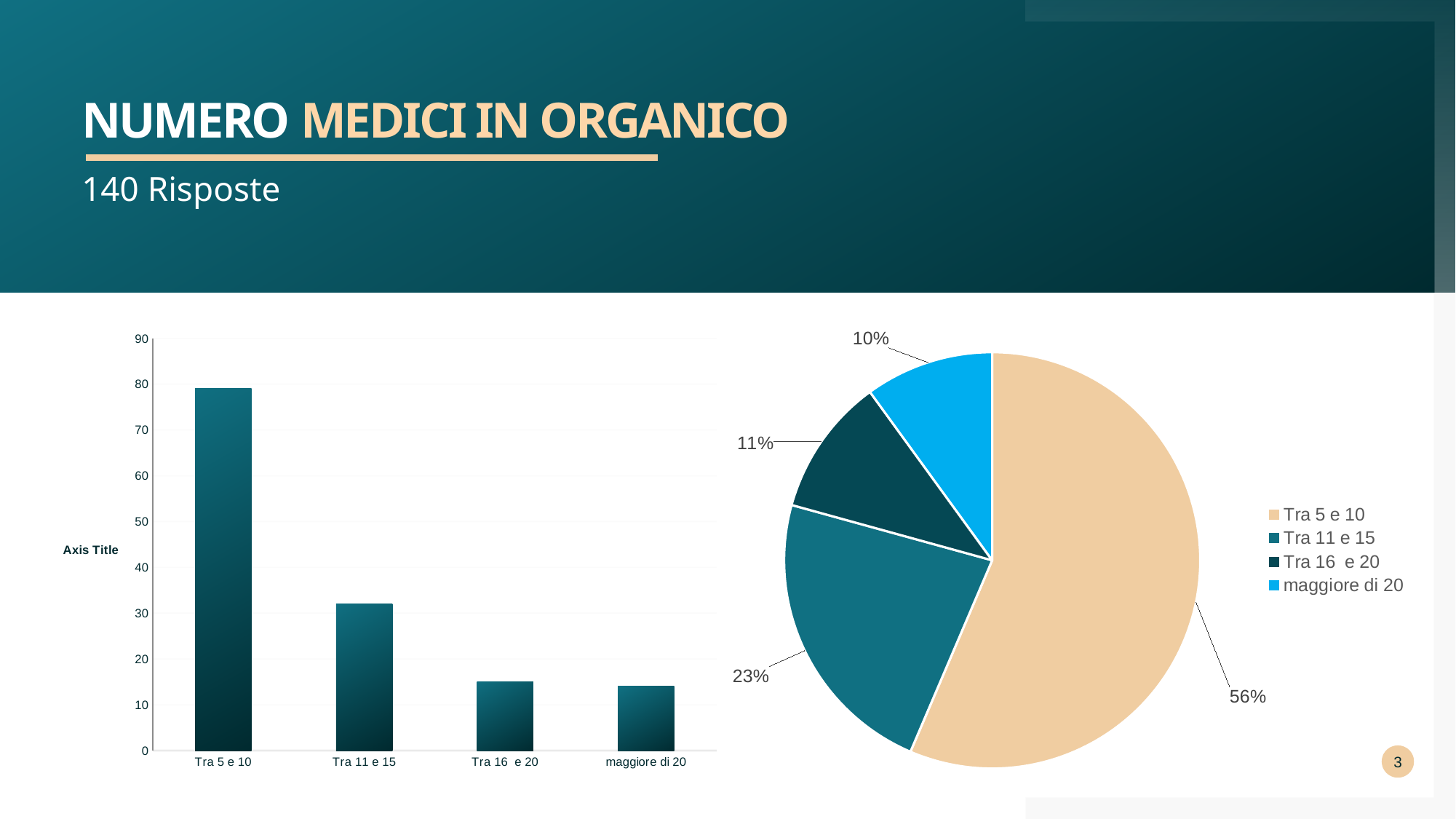
What kind of chart is the chart on the right of the slide? Pie chart How many entries does the legend of the pie chart on the right list? 4 What kind of chart is the chart on the left of the slide? Bar chart In the bar chart on the left, is the value for Tra 5 e 10 greater or less than 70? greater In the bar chart on the left, which is larger, the bar for Tra 11 e 15 or the bar for Tra 16 e 20? Tra 11 e 15 In the pie chart on the right, what percentage is shown for maggiore di 20? 10% In the pie chart on the right, what percentage is shown for Tra 11 e 15? 23% In the bar chart on the left, how many categories are shown on the x axis? 4 In the bar chart on the left, which category has the highest bar? Tra 5 e 10 In the bar chart on the left, is the value for Tra 11 e 15 greater or less than 40? less In the pie chart on the right, what is the difference in percentage points between Tra 5 e 10 and Tra 11 e 15? 33 In the pie chart on the right, what share does Tra 5 e 10 have? 56%